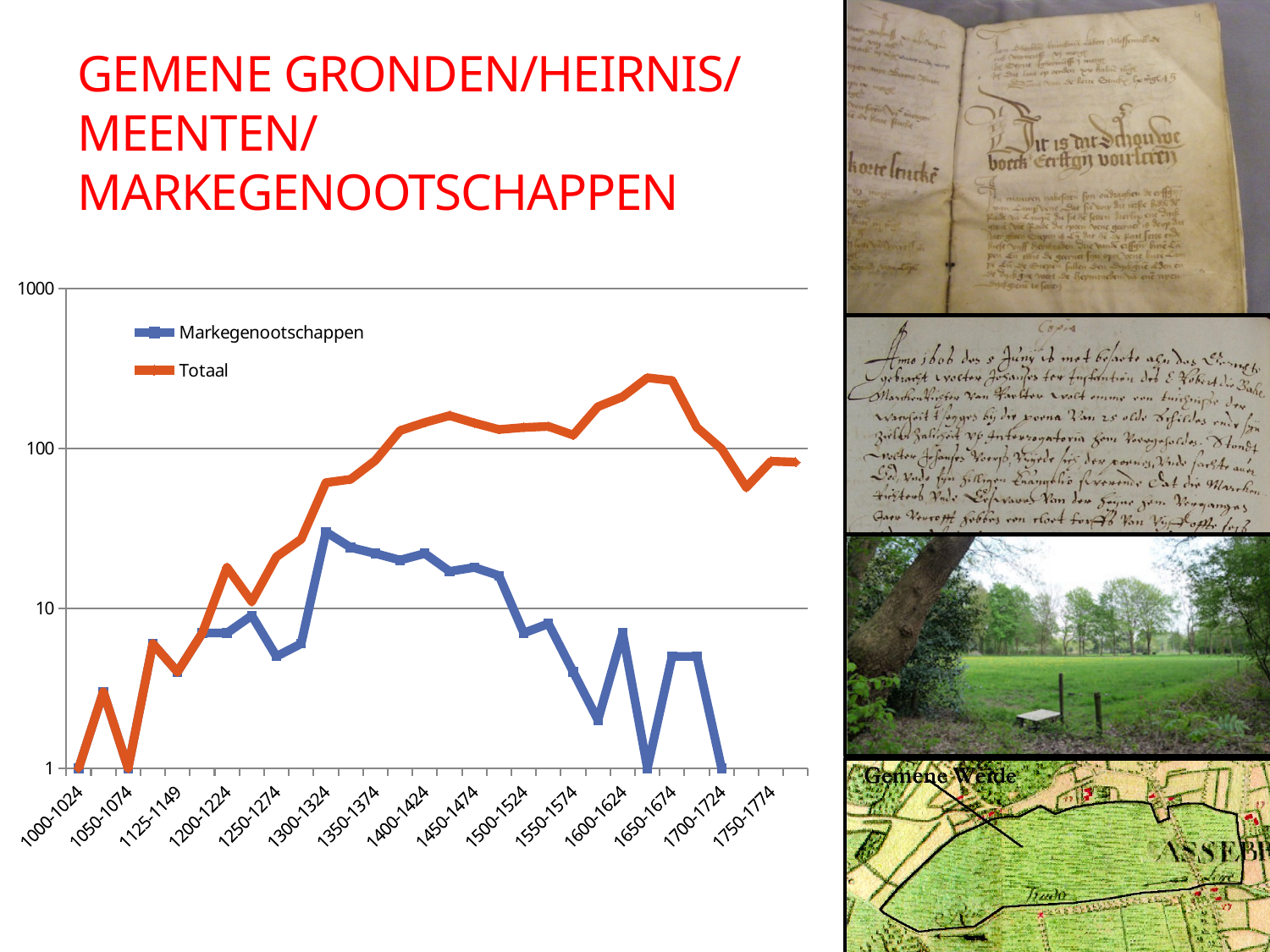
How many series does the chart legend list? 2 Which colour is used for the Totaal series? orange Is the value of Totaal for 1400-1424 greater or less than 100? greater Which series has the larger value for 1500-1524, Markegenootschappen or Totaal? Totaal What is the value of Markegenootschappen for 1000-1024? 1 What is the value of Markegenootschappen for 1700-1724? 1 Does the Markegenootschappen series rise or fall between 1300-1324 and 1700-1724? fall What are the two series named in the chart legend? Markegenootschappen and Totaal Is the value of Totaal for 1650-1674 greater or less than 100? greater Is the value of Totaal for 1750-1774 greater or less than 100? less What kind of chart is shown on the slide? line chart